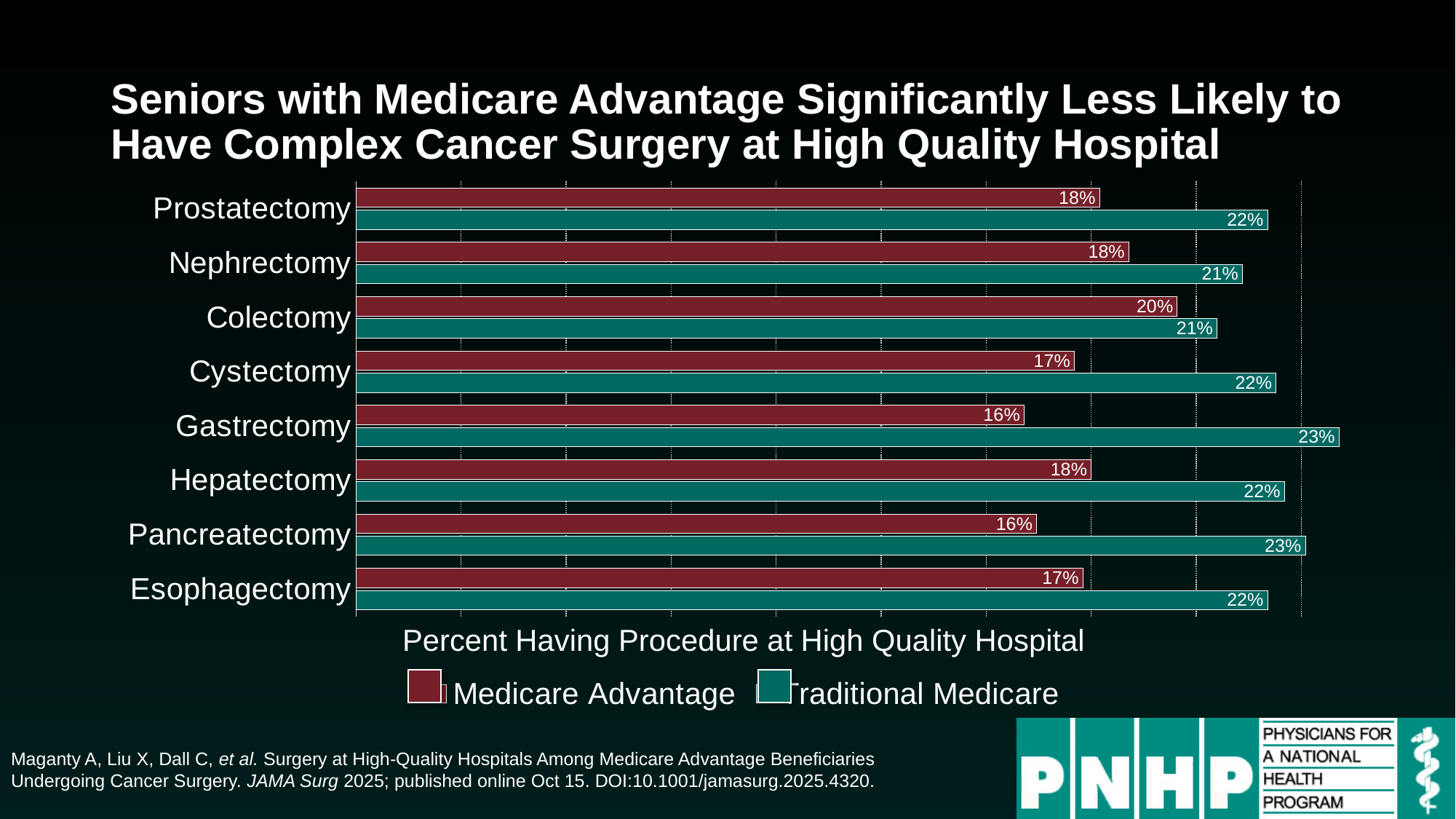
What is the Traditional Medicare value for Gastrectomy? 23% Which procedure has the highest Medicare Advantage percentage? Colectomy What is the difference between the Traditional Medicare and Medicare Advantage values for Gastrectomy? 7 percentage points How many series does the legend list? 2 What kind of chart is shown on the slide? Bar chart What is the label of the horizontal axis? Percent Having Procedure at High Quality Hospital What is the Traditional Medicare value for Nephrectomy? 21% How many procedures are shown on the chart? 8 What is the difference between the Traditional Medicare and Medicare Advantage values for Colectomy? 1 percentage point What percent of Medicare Advantage seniors had a prostatectomy at a high quality hospital? 18% What is the Medicare Advantage value for Colectomy? 20% For Pancreatectomy, which is larger: the Medicare Advantage value or the Traditional Medicare value? Traditional Medicare